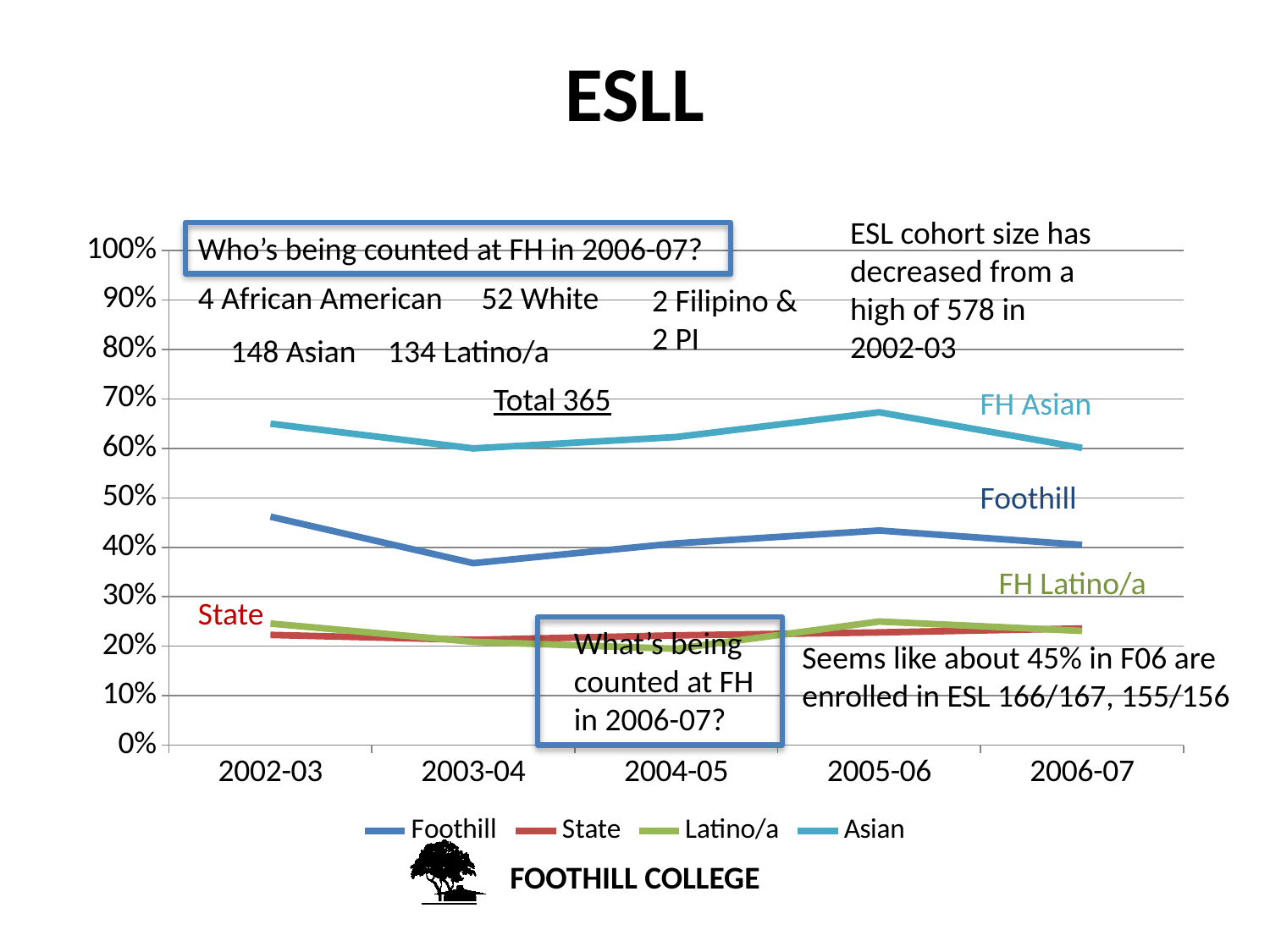
Does the Foothill series rise or fall from 2002-03 to 2003-04? fall In which year is the Foothill series at its lowest? 2003-04 In which year is the Asian series at its highest? 2005-06 How many series does the legend list? 4 Is the value for Asian in 2002-03 greater or less than 60%? greater How many academic years are shown on the x axis? 5 What kind of chart is shown on the slide? line chart What is the title of the slide containing the chart? ESLL Is the value for Foothill in 2003-04 greater or less than 40%? less Which series has the highest value in 2005-06? Asian Which is larger in 2006-07, the Foothill value or the Asian value? Asian Is the value for State in 2002-03 greater or less than 30%? less